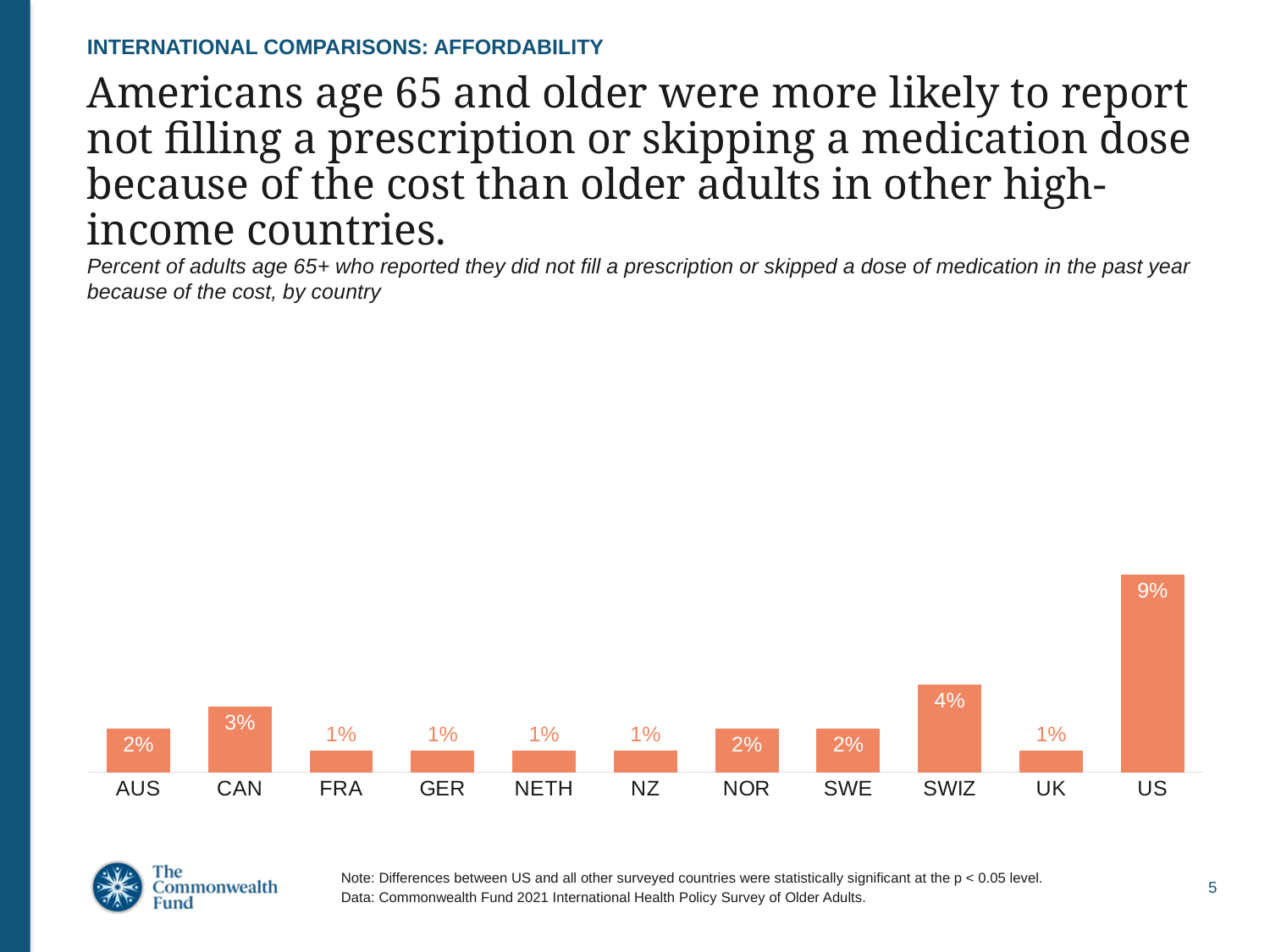
According to the note, at what level were differences between the US and other countries statistically significant? p < 0.05 Which is larger, the value for CAN or the value for AUS? CAN What is the difference between the US value and the SWIZ value? 5% How many countries have a value of 1%? 5 What kind of chart is shown on the slide? Bar chart What is the difference between the CAN value and the UK value? 2% What percent of adults age 65+ in the US reported not filling a prescription or skipping a dose because of cost? 9% How many countries are shown in the chart? 11 What is the value shown for CAN? 3% What is the value shown for SWIZ? 4% Which country has the highest percentage in the chart? US What is the value shown for NOR? 2%